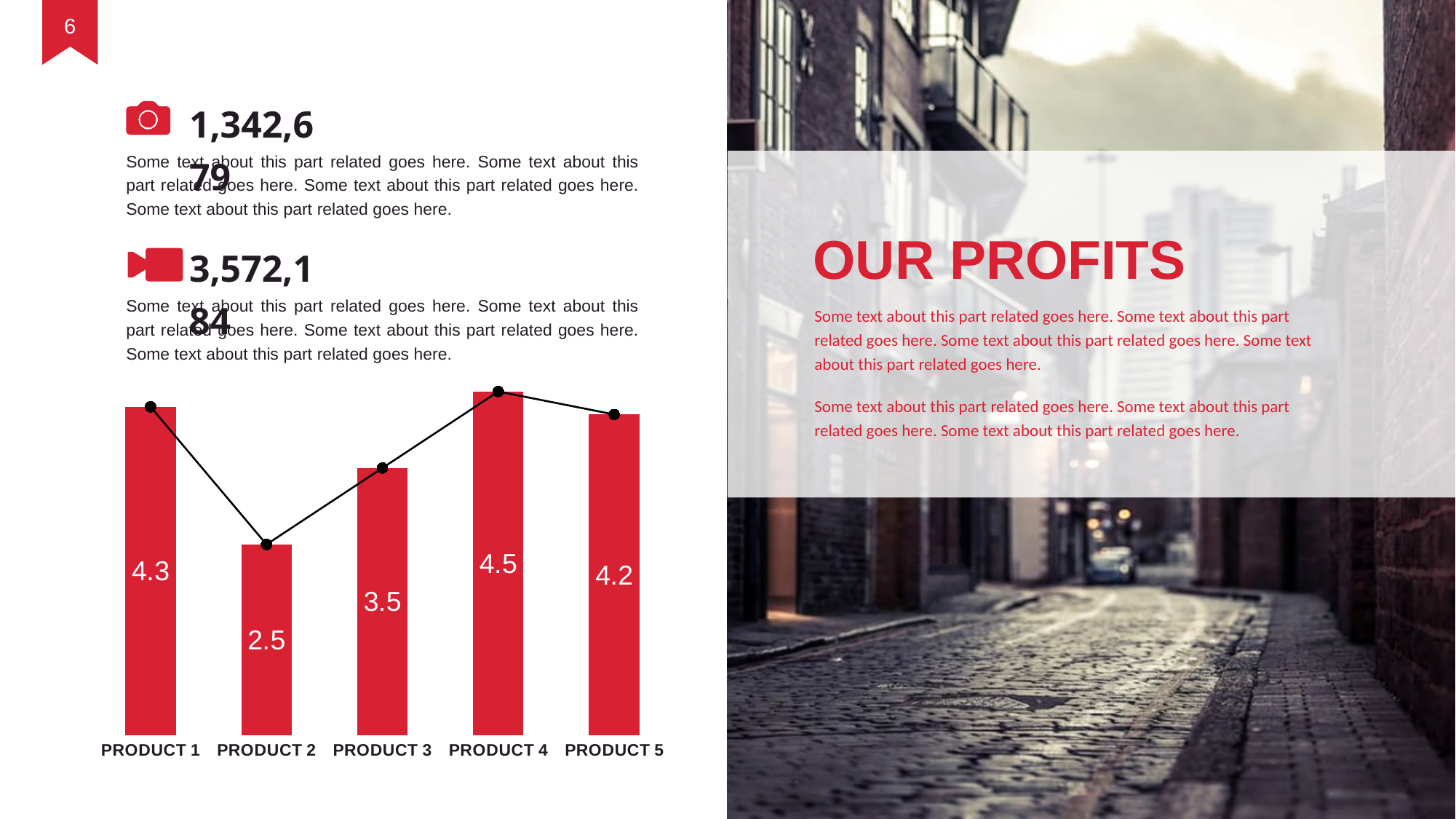
How many products are shown in the chart? 5 What is the difference between the values for PRODUCT 1 and PRODUCT 3? 0.8 Which product has the highest value? PRODUCT 4 Which product has the lowest value? PRODUCT 2 What is the value for PRODUCT 1? 4.3 What is the value for PRODUCT 3? 3.5 What colour are the bars in the chart? Red What is the value for PRODUCT 2? 2.5 What kind of chart is shown on the slide? Bar chart with a line overlay Which is larger, the value for PRODUCT 3 or the value for PRODUCT 5? PRODUCT 5 What is the difference between the values for PRODUCT 4 and PRODUCT 2? 2 What is the value for PRODUCT 5? 4.2